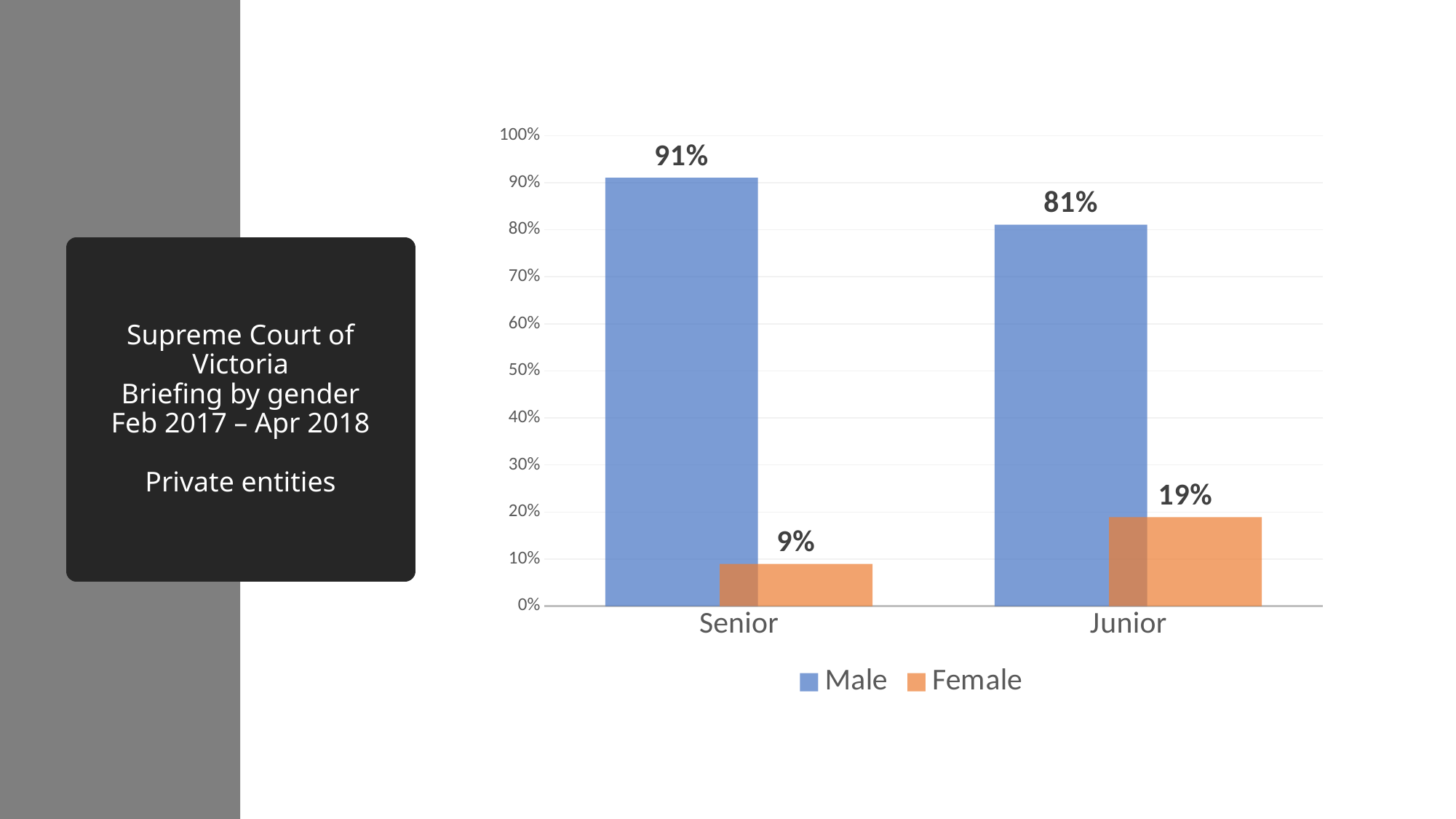
How many categories are shown on the x axis? 2 What is the Male value for Senior? 91% What is the difference between the Male and Female values for Junior? 62% What is the Female value for Senior? 9% Which category has the highest Male value? Senior What is the Male value for Junior? 81% Which category has the lowest Female value? Senior Which is larger, the Female value for Senior or the Female value for Junior? Junior What kind of chart is shown on the slide? Bar chart Which colour represents the Female series? Orange How many series does the legend list? 2 What is the Female value for Junior? 19%